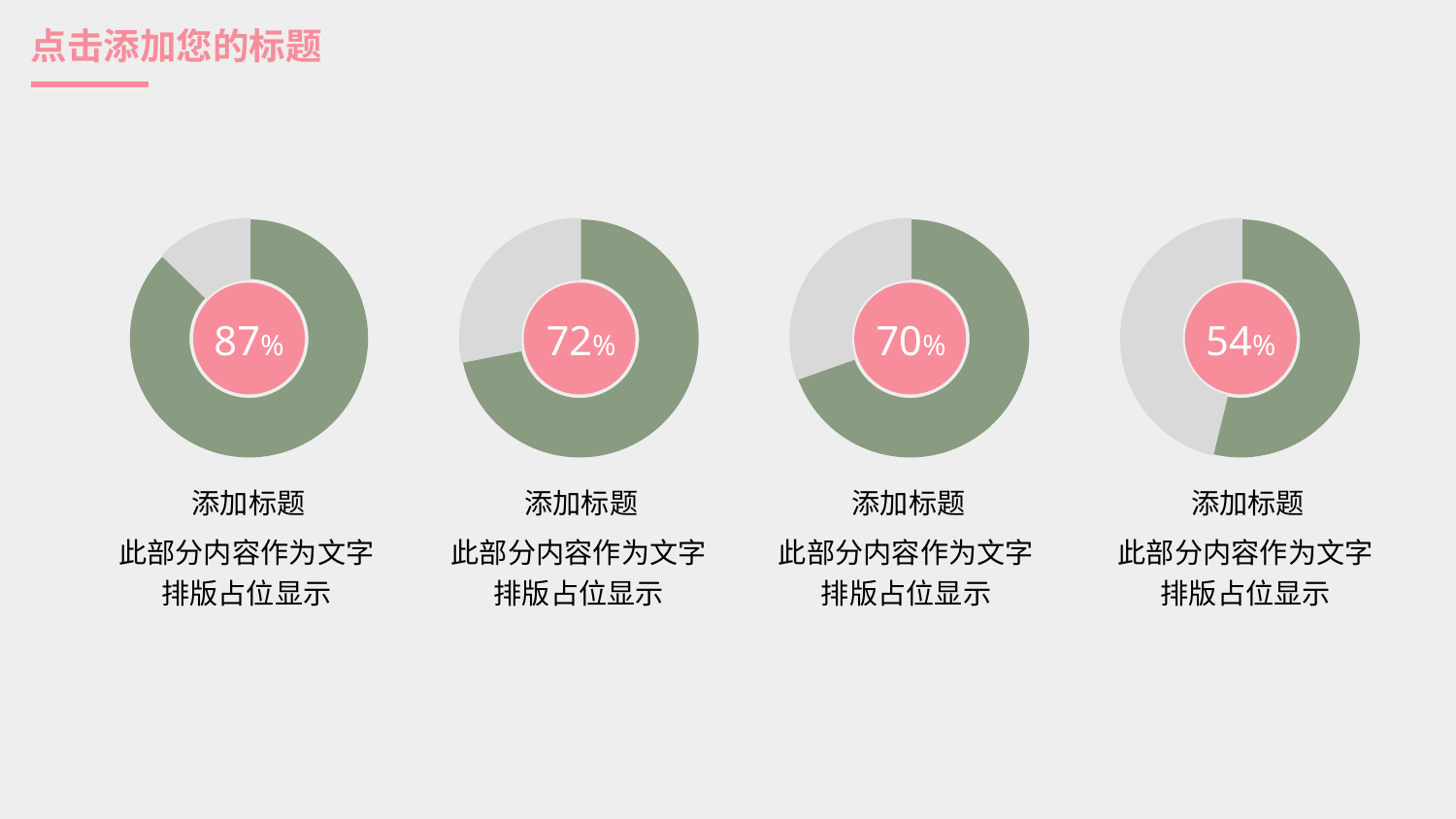
What percentage is shown in the centre of the rightmost donut chart? 54% What colour is the filled (completed) portion of each donut chart? Green What percentage is shown in the centre of the leftmost donut chart? 87% What is the difference between the percentage in the leftmost donut chart and the percentage in the rightmost donut chart? 33% How many donut charts are on the slide? 4 Which donut chart shows the highest percentage? The leftmost chart (87%) What percentage is shown in the centre of the third donut chart from the left? 70% Which is larger: the percentage in the second donut chart from the left or the percentage in the third donut chart from the left? The second chart (72%) Which donut chart shows the lowest percentage? The rightmost chart (54%) What kind of chart is used on this slide? Donut chart What is the difference between the percentages in the second and third donut charts from the left? 2% What percentage is shown in the centre of the second donut chart from the left? 72%